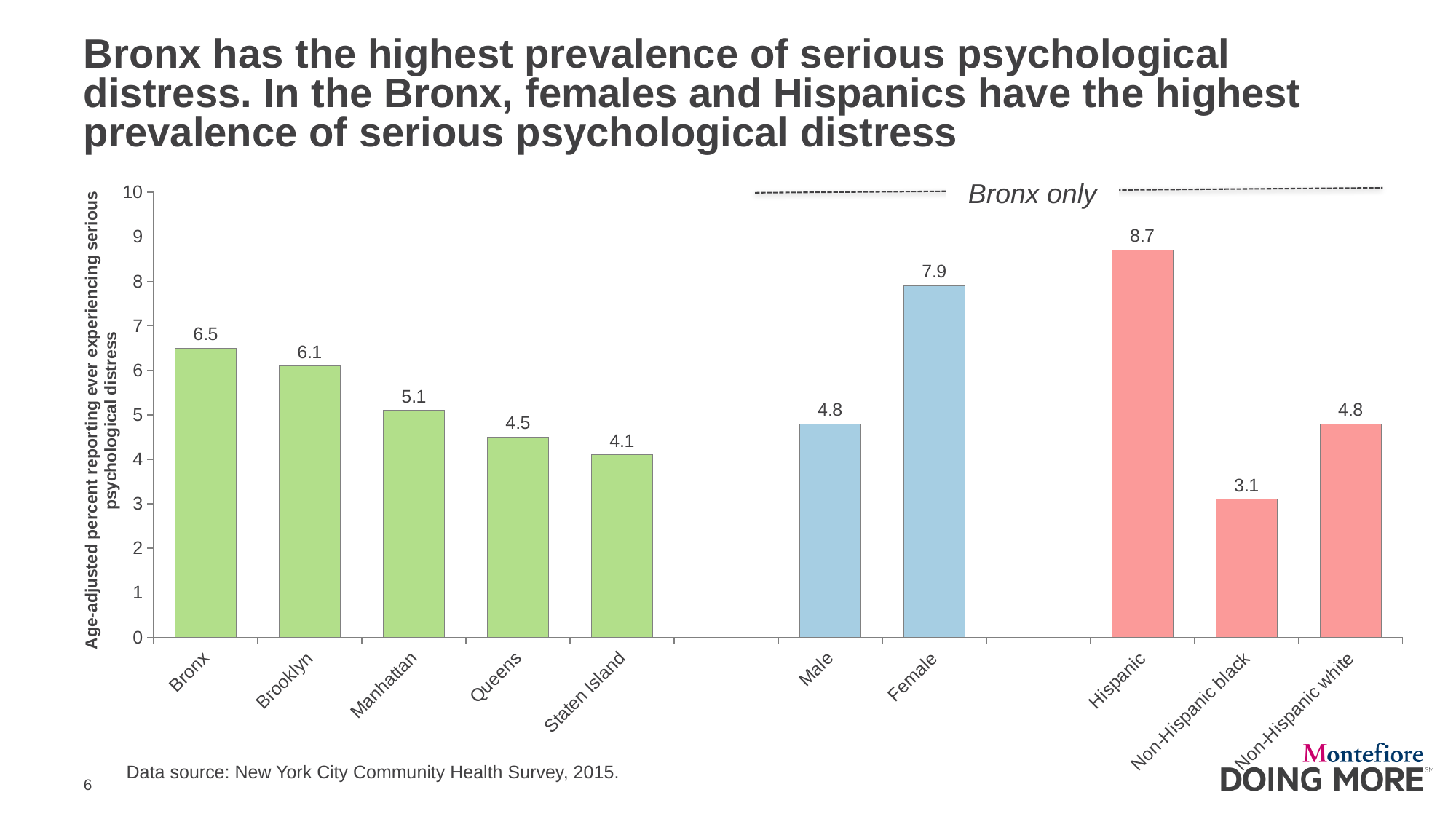
Which category has the lowest value on the chart? Non-Hispanic black What is the value for Female? 7.9 Among the five boroughs, which has the lowest value? Staten Island What kind of chart is shown on the slide? Bar chart Which category has the highest value on the chart? Hispanic How many bars are plotted on the chart? 10 What is the difference between the values for Bronx and Staten Island? 2.4 Do the values rise or fall from Bronx to Staten Island along the x axis? Fall Which is larger, the value for Brooklyn or the value for Manhattan? Brooklyn What is the value for Bronx? 6.5 What is the difference between the values for Female and Male? 3.1 What is the value for Non-Hispanic black? 3.1